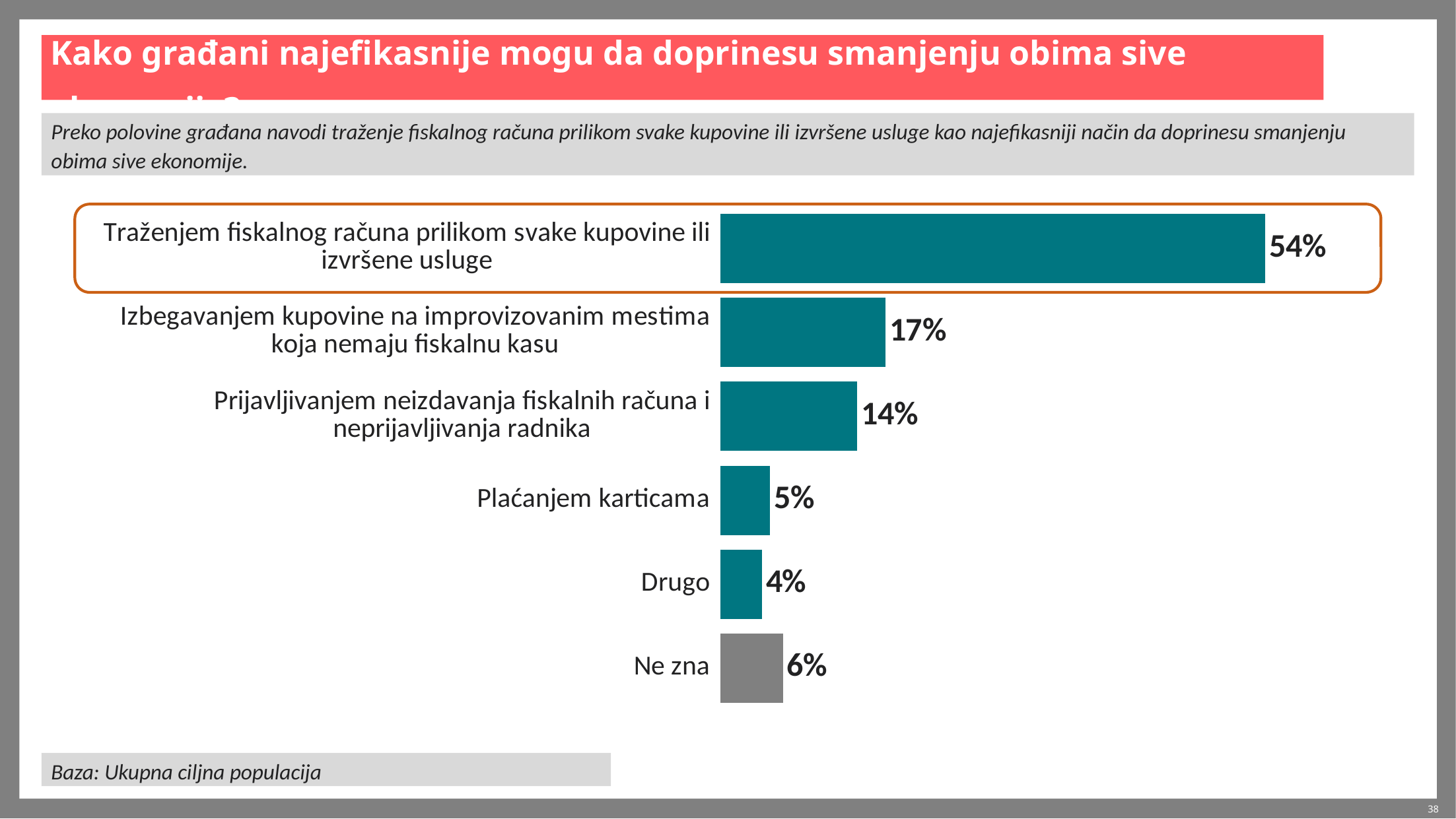
Which is larger: the value for "Ne zna" or the value for "Plaćanjem karticama"? Ne zna How many categories are shown in the chart? 6 What is the difference between the values for "Izbegavanjem kupovine na improvizovanim mestima koja nemaju fiskalnu kasu" and "Prijavljivanjem neizdavanja fiskalnih računa i neprijavljivanja radnika"? 3% What is the value for "Plaćanjem karticama"? 5% What is the value for "Ne zna"? 6% What is the difference between the highest value and the value for "Drugo"? 50% Which category has the lowest value? Drugo What kind of chart is shown on the slide? Bar chart Which bar is shown in a different colour (grey) from the others? Ne zna What is the value for "Izbegavanjem kupovine na improvizovanim mestima koja nemaju fiskalnu kasu"? 17% Which category has the highest value? Traženjem fiskalnog računa prilikom svake kupovine ili izvršene usluge What percentage of citizens chose "Traženjem fiskalnog računa prilikom svake kupovine ili izvršene usluge"? 54%